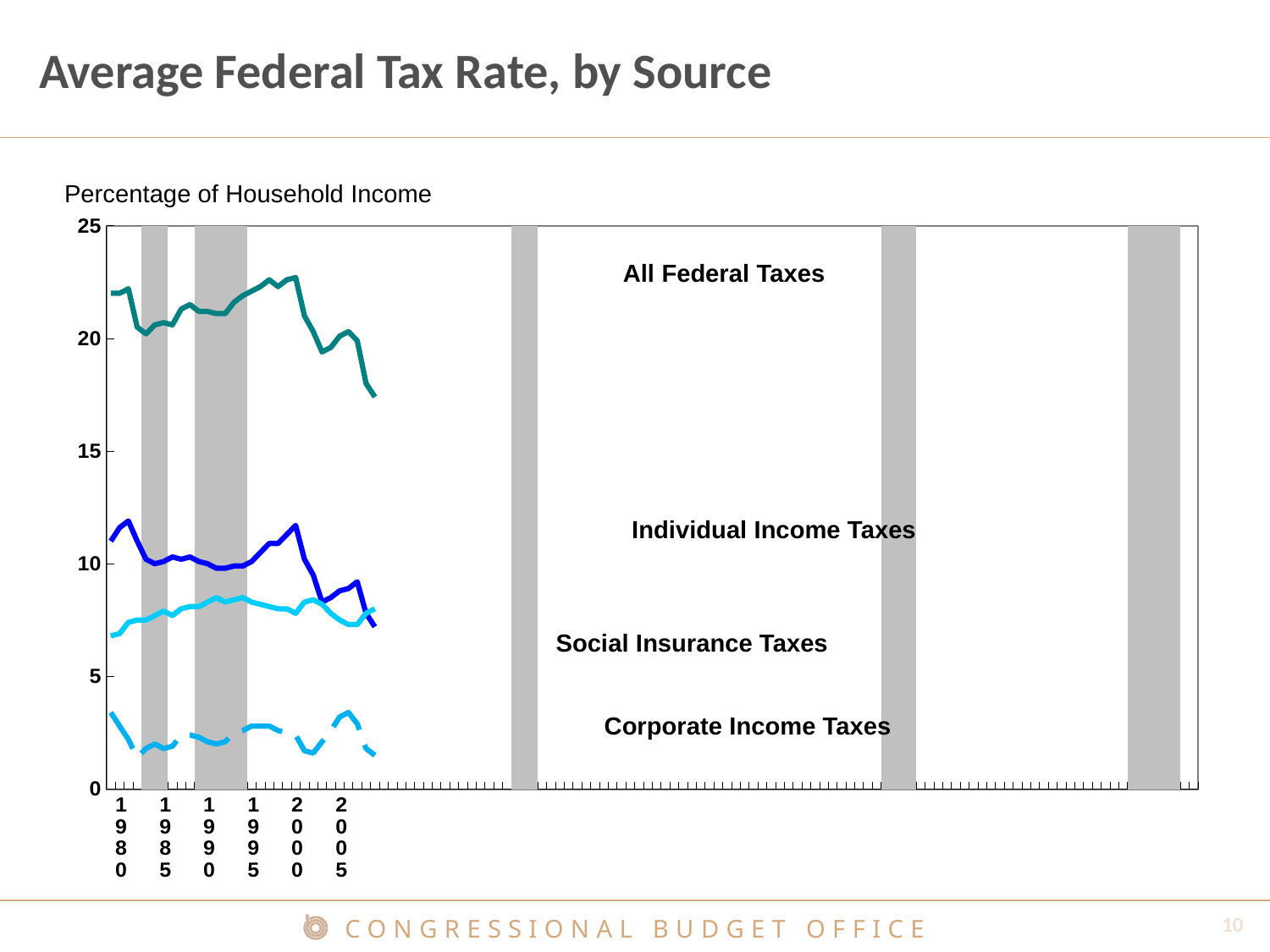
Is the value for Social Insurance Taxes in 1980 greater or less than 10? less Is the value for Individual Income Taxes in 2000 greater or less than 10? greater Which series has the highest values throughout the chart? All Federal Taxes How many tax series are plotted on the chart? 4 What kind of chart is shown on the slide? line chart Does the All Federal Taxes line rise or fall between 2000 and the end of the series? fall In 2005, which is larger: Social Insurance Taxes or Corporate Income Taxes? Social Insurance Taxes Is the value for All Federal Taxes in 1980 greater or less than 20? greater In 1990, which is larger: Individual Income Taxes or Social Insurance Taxes? Individual Income Taxes What is the title of the chart? Average Federal Tax Rate, by Source Which series has the lowest values throughout the chart? Corporate Income Taxes